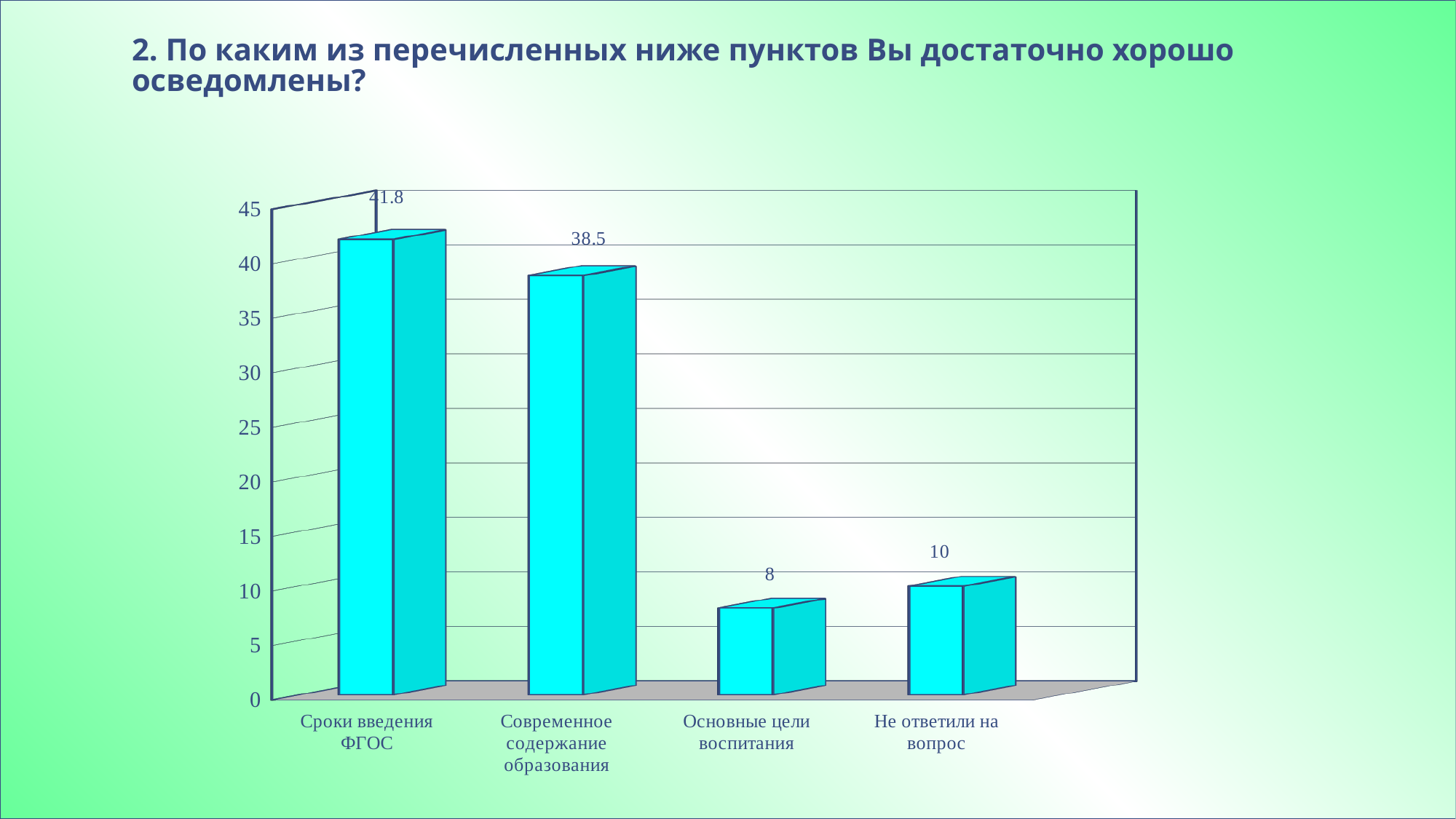
What is the value for Не ответили на вопрос? 10 How many categories are shown on the chart? 4 Is the value for Современное содержание образования greater or less than 40? less Which category has the lowest value? Основные цели воспитания What is the value for Современное содержание образования? 38.5 What kind of chart is shown on the slide? bar chart What is the difference between the values for Сроки введения ФГОС and Современное содержание образования? 3.3 What is the value for Основные цели воспитания? 8 What is the value for Сроки введения ФГОС? 41.8 What is the difference between the values for Не ответили на вопрос and Основные цели воспитания? 2 Which is larger: the value for Основные цели воспитания or the value for Не ответили на вопрос? Не ответили на вопрос Which category has the highest value? Сроки введения ФГОС